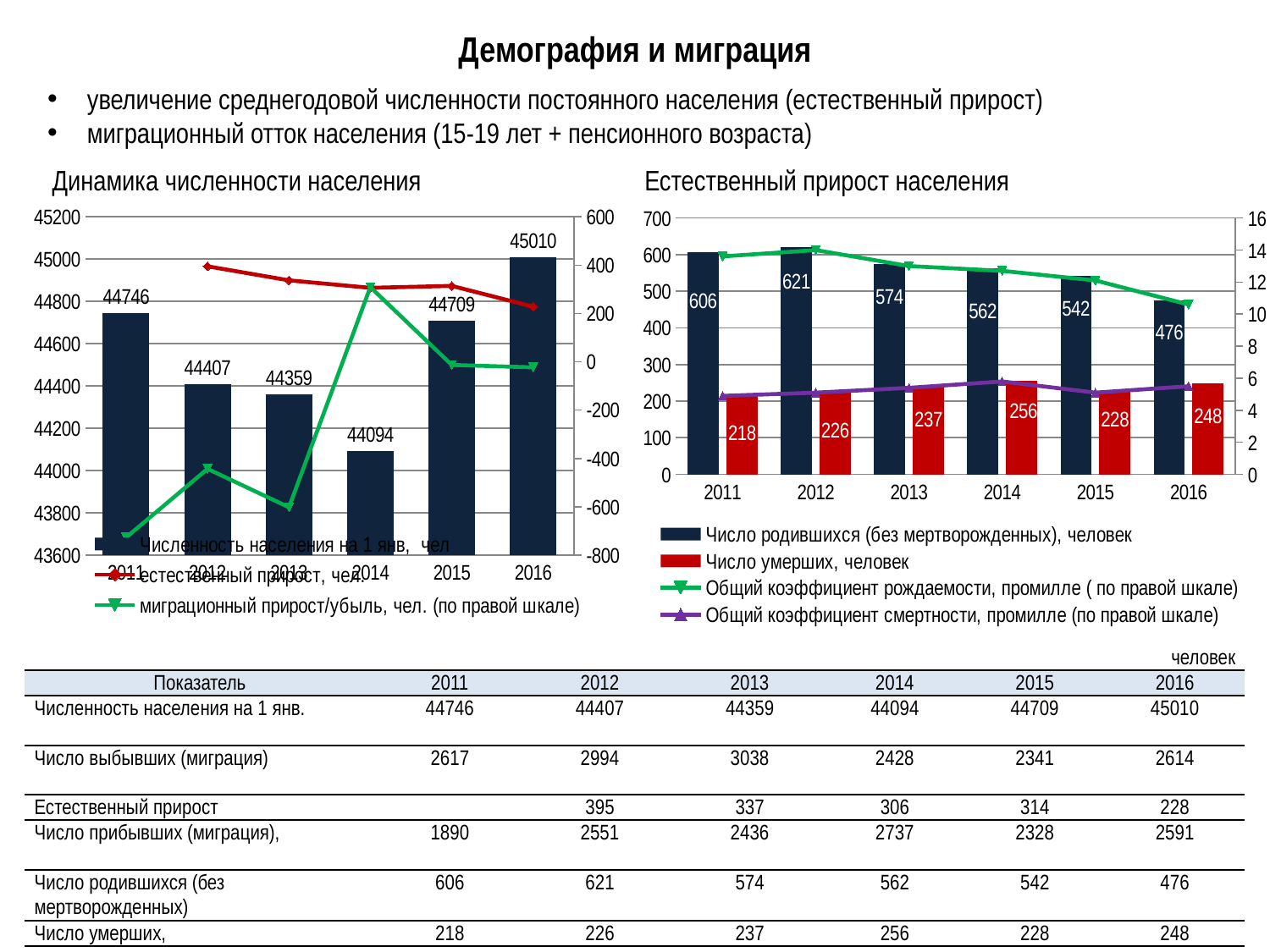
In the chart 'Динамика численности населения', which year has the lowest population bar? 2014 In the chart 'Динамика численности населения', how many years are shown on the x axis? 6 In the chart 'Естественный прирост населения', how many people were born in 2012? 621 In the chart 'Динамика численности населения', what is the difference between the population values for 2016 and 2014? 916 In the chart 'Естественный прирост населения', which year has the lowest number of deaths? 2011 In the chart 'Естественный прирост населения', which year has the highest number of births? 2012 In the chart 'Естественный прирост населения', how many deaths are shown for 2014? 256 In the chart 'Естественный прирост населения', what is the difference between births and deaths in 2016? 228 In the chart 'Естественный прирост населения', how many series does the legend list? 4 In the chart 'Динамика численности населения', what is the population value shown for 2016? 45010 In the chart 'Динамика численности населения', is the migration value (green line, right scale) for 2014 greater or less than 200? greater In the chart 'Естественный прирост населения', do the number of births rise or fall from 2012 to 2016? fall